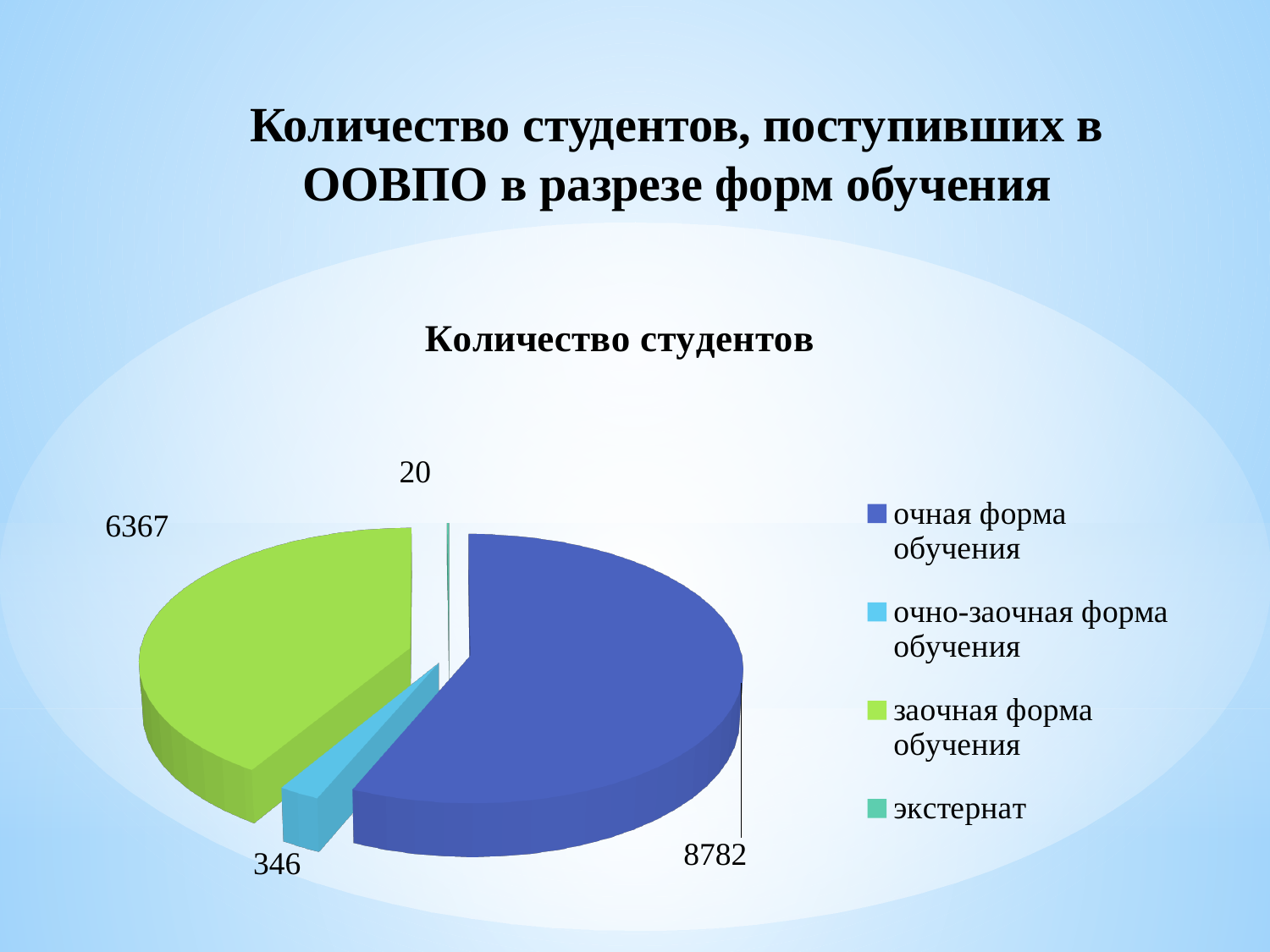
What is the value for заочная форма обучения? 6367 What is the value for очная форма обучения? 8782 What is the value for экстернат? 20 Which category has the smallest value? экстернат Which category has the largest value? очная форма обучения Which is larger, the value for очно-заочная форма обучения or the value for экстернат? очно-заочная форма обучения How many slices does the pie chart have? 4 How many series does the legend list? 4 What is the title of the chart? Количество студентов What type of chart is shown on the slide? Pie chart What is the value for очно-заочная форма обучения? 346 What is the difference between the values for очная форма обучения and заочная форма обучения? 2415